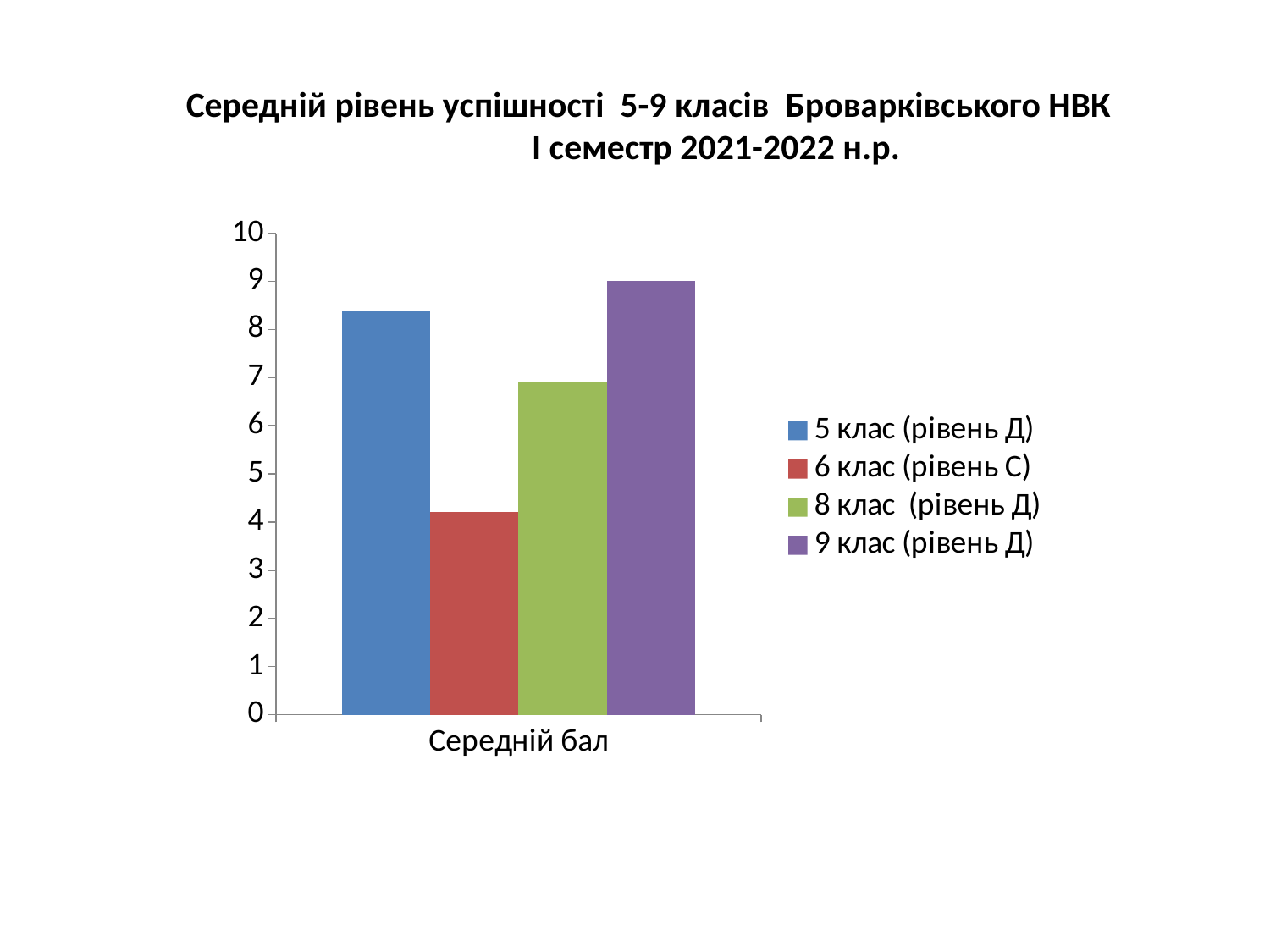
Which series has the lowest value for Середній бал? 6 клас (рівень С) What is the label of the category on the x axis? Середній бал What kind of chart is shown on the slide? bar chart What colour is the bar for 6 клас (рівень С)? red How many series does the legend list? 4 Is the value for 5 клас (рівень Д) greater or less than 8? greater Is the value for 6 клас (рівень С) greater or less than 5? less What is the value for 9 клас (рівень Д)? 9 Which series has the highest value for Середній бал? 9 клас (рівень Д) Which is larger, the value for 5 клас (рівень Д) or the value for 8 клас (рівень Д)? 5 клас (рівень Д) How many categories are shown on the x axis? 1